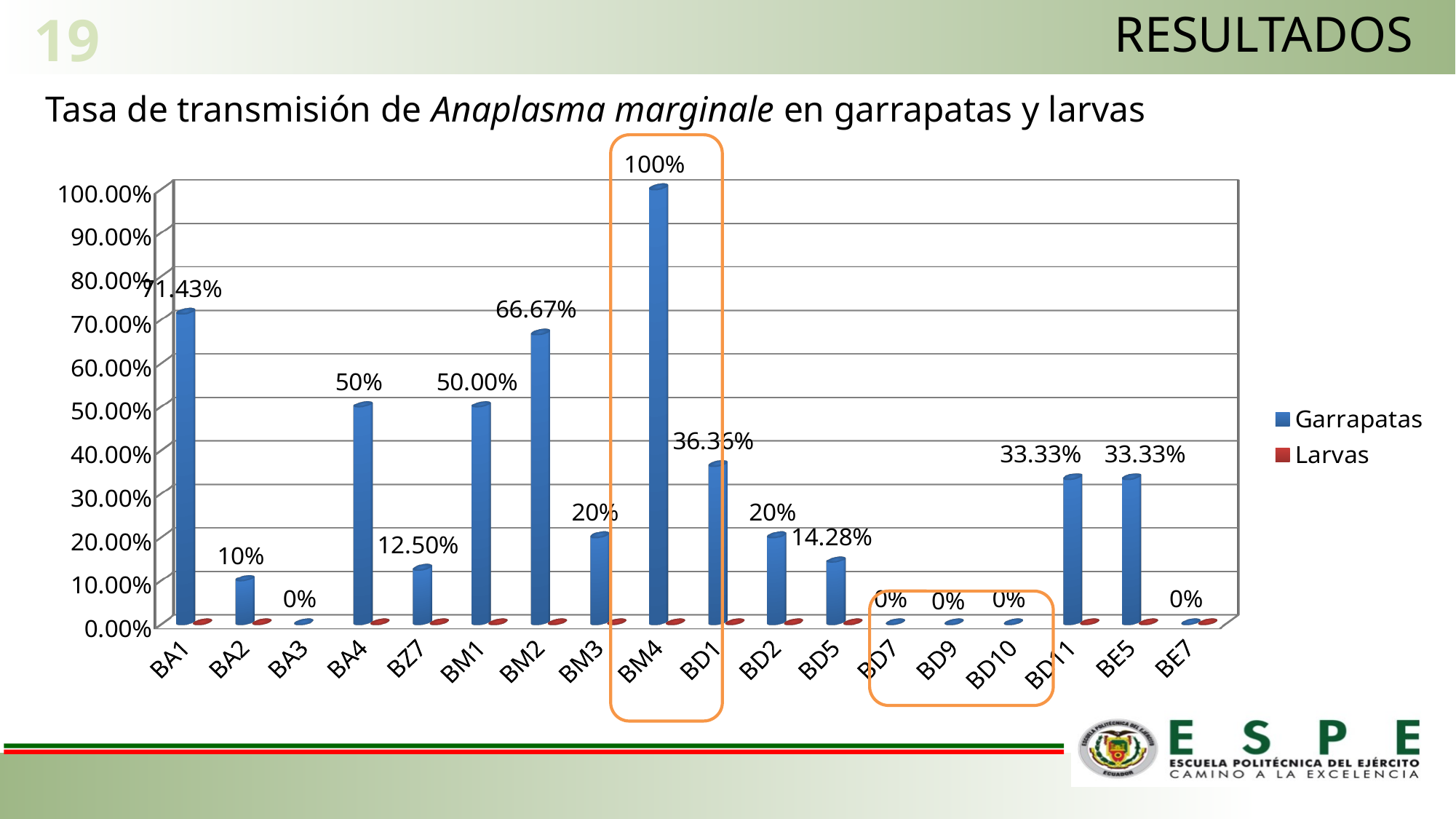
What is the Garrapatas value for BZ7? 12.50% How many series does the legend list? 2 Is the Garrapatas value for BD11 greater or less than 40.00%? less What is the difference between the Garrapatas values for BA1 and BM2? 4.76% How many categories are shown on the x axis? 18 Which has a larger Garrapatas value, BA2 or BM3? BM3 What is the Garrapatas value for BD1? 36.36% Which category has the highest Garrapatas value? BM4 What kind of chart is shown on the slide? bar chart What is the Garrapatas value for BM2? 66.67% What is the Garrapatas value for BD5? 14.28% What are the two series named in the legend? Garrapatas and Larvas